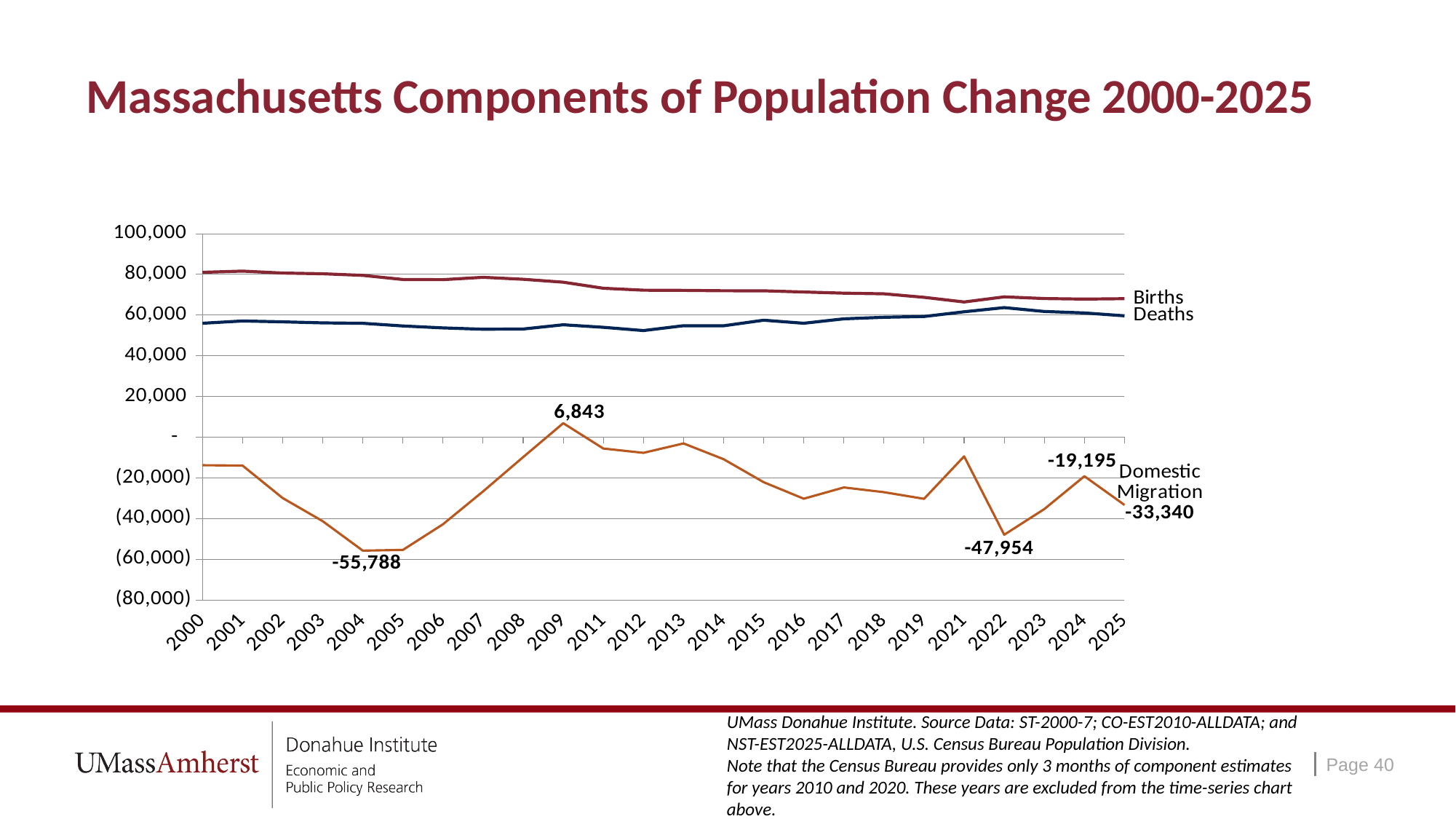
Is the value for Births in 2025 greater or less than 80,000? less Is the value for Deaths in 2012 greater or less than 60,000? less What is the Domestic Migration value for 2022? -47,954 Which is larger in 2000, Births or Deaths? Births How many years are shown on the x axis? 24 What is the difference between the Domestic Migration values for 2024 and 2025? 14,145 What is the Domestic Migration value for 2025? -33,340 In which year is Domestic Migration at its lowest? 2004 In which year is Domestic Migration at its highest? 2009 What is the Domestic Migration value for 2004? -55,788 What is the Domestic Migration value for 2009? 6,843 What kind of chart is shown on the slide? Line chart